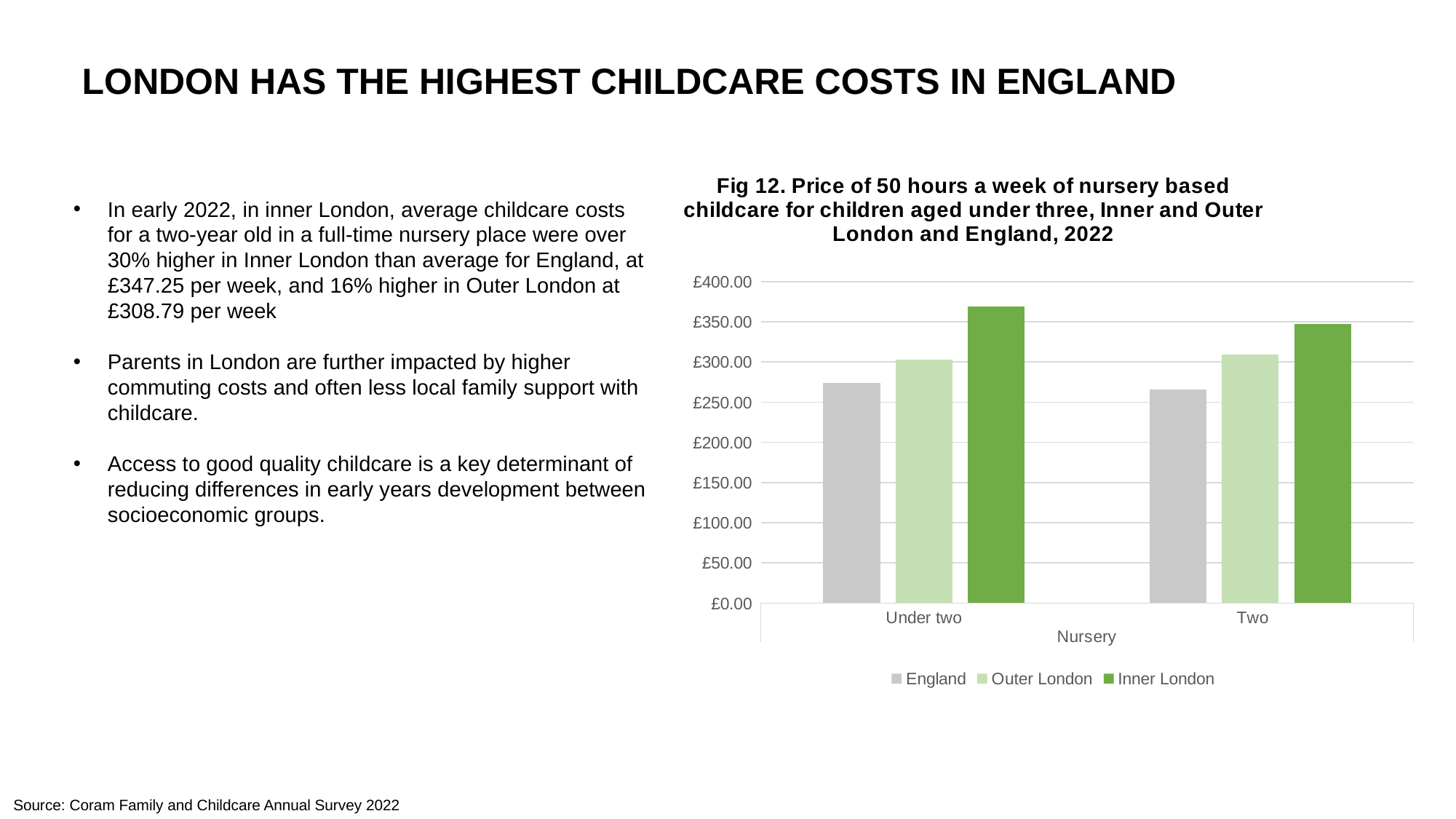
Does the Inner London value rise or fall from Under two to Two? fall How many series does the legend of Fig 12 list? 3 How many age categories are shown on the x axis of Fig 12? 2 What is the label on the x axis of Fig 12? Nursery In the Two category, which is larger: the Inner London bar or the England bar? Inner London Which series has the shortest bar in the Two category? England Which series has the tallest bar in the Under two category? Inner London Is the value for England in the Two category greater or less than £250.00? greater What kind of chart is shown in Fig 12? bar chart Is the value for England in the Under two category greater or less than £300.00? less Is the value for Inner London in the Two category greater or less than £400.00? less